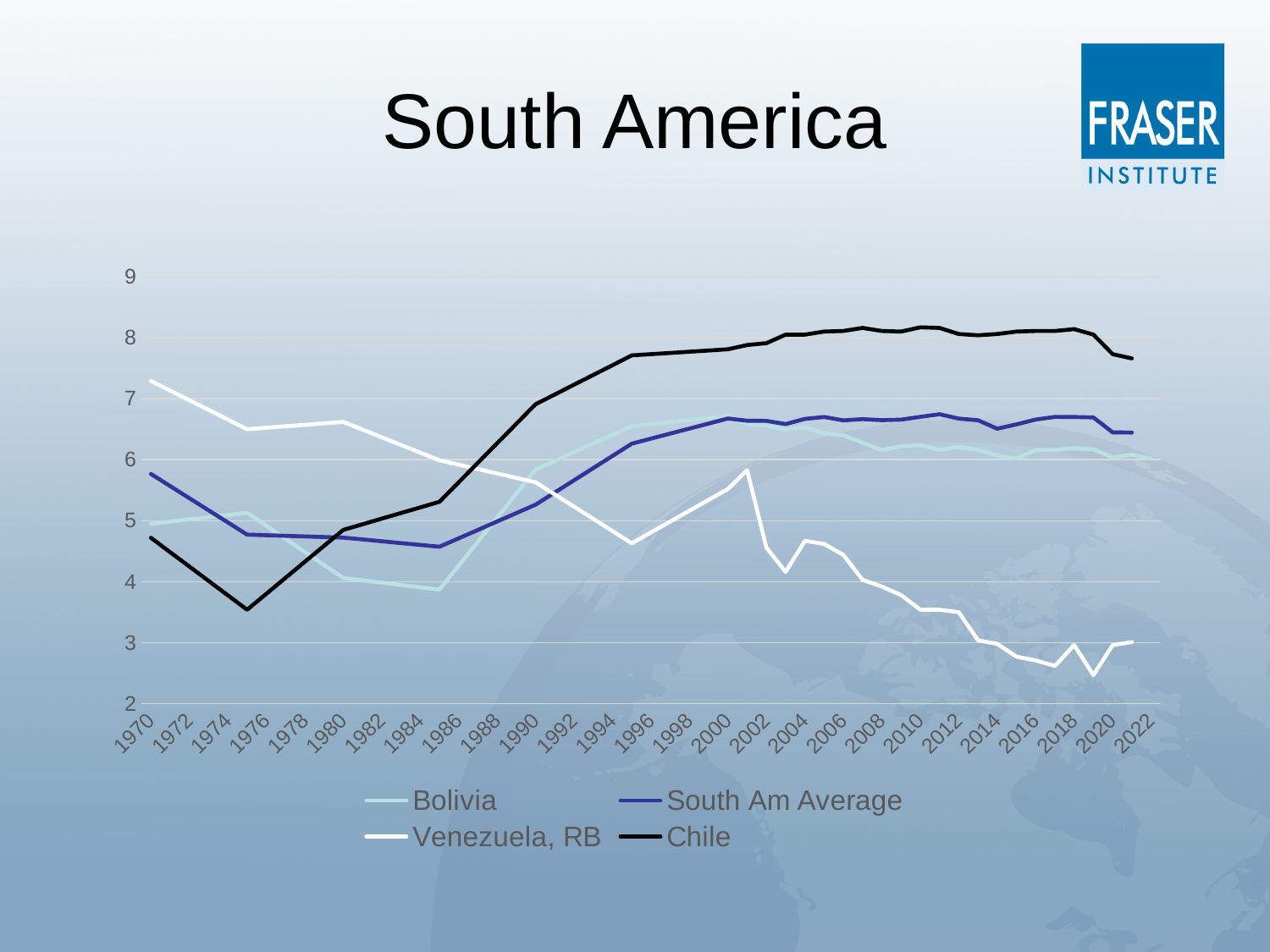
Is the value for Chile in 2010 greater or less than 7? greater Which series is drawn in black? Chile In 1970, which is larger: the value for Venezuela, RB or the value for Chile? Venezuela, RB Which series has the lowest value in 1975? Chile What is the title of the slide? South America What kind of chart is shown on the slide? line chart Is the value for Bolivia in 1985 greater or less than 5? less Is the value for Venezuela, RB in 2018 greater or less than 4? less How many series does the legend list? 4